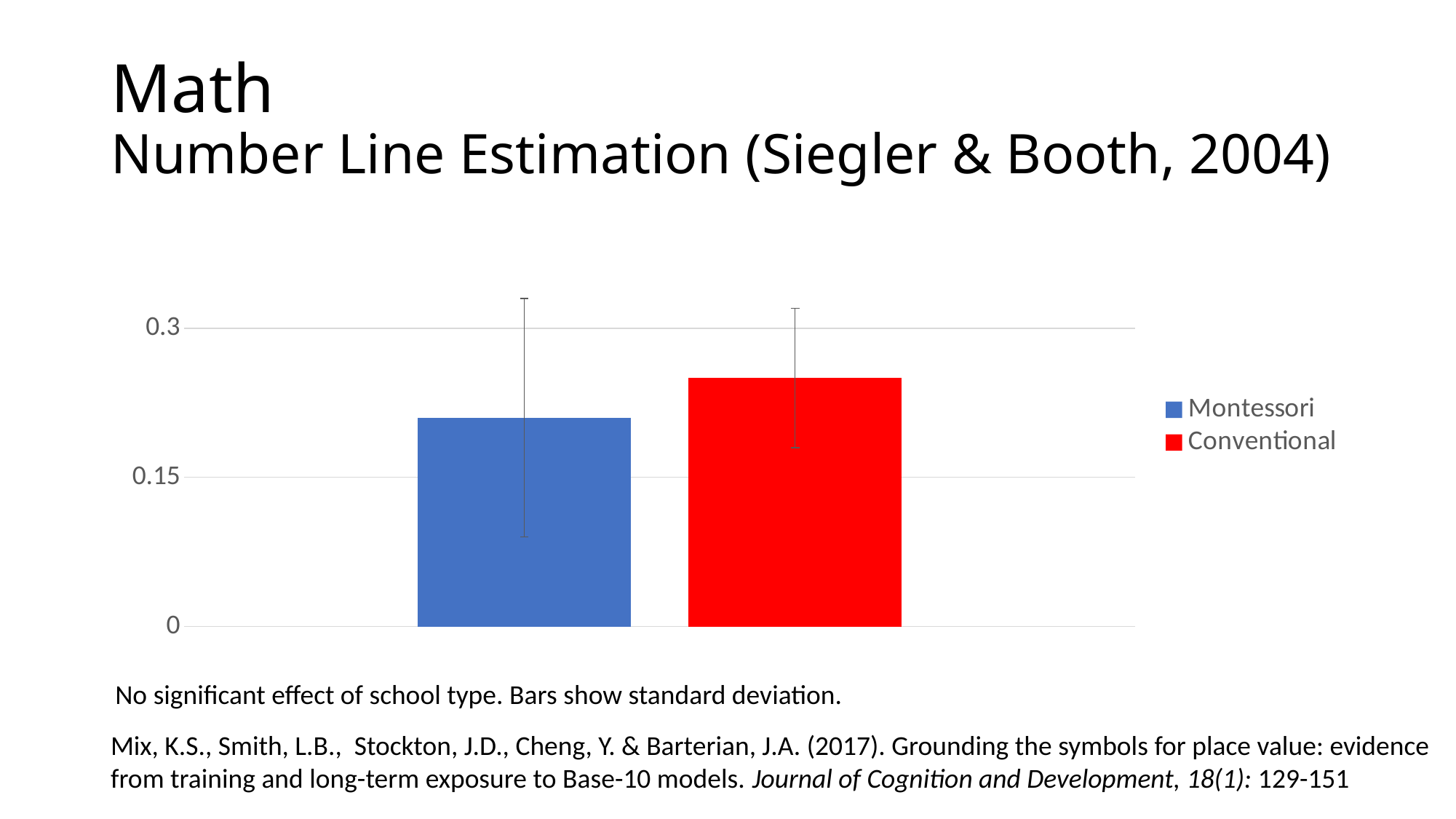
Is the value for Conventional greater or less than 0.3? less According to the note below the chart, what do the error bars show? standard deviation What kind of chart is shown on the slide? bar chart Which series has the taller bar, Montessori or Conventional? Conventional How many bars are plotted in the chart? 2 How many series does the legend list? 2 Which series has the highest value in the chart? Conventional Is the value for Montessori greater or less than 0.3? less Which series has the lowest value in the chart? Montessori What colour is the Conventional bar? red Is the value for Montessori greater or less than 0.15? greater